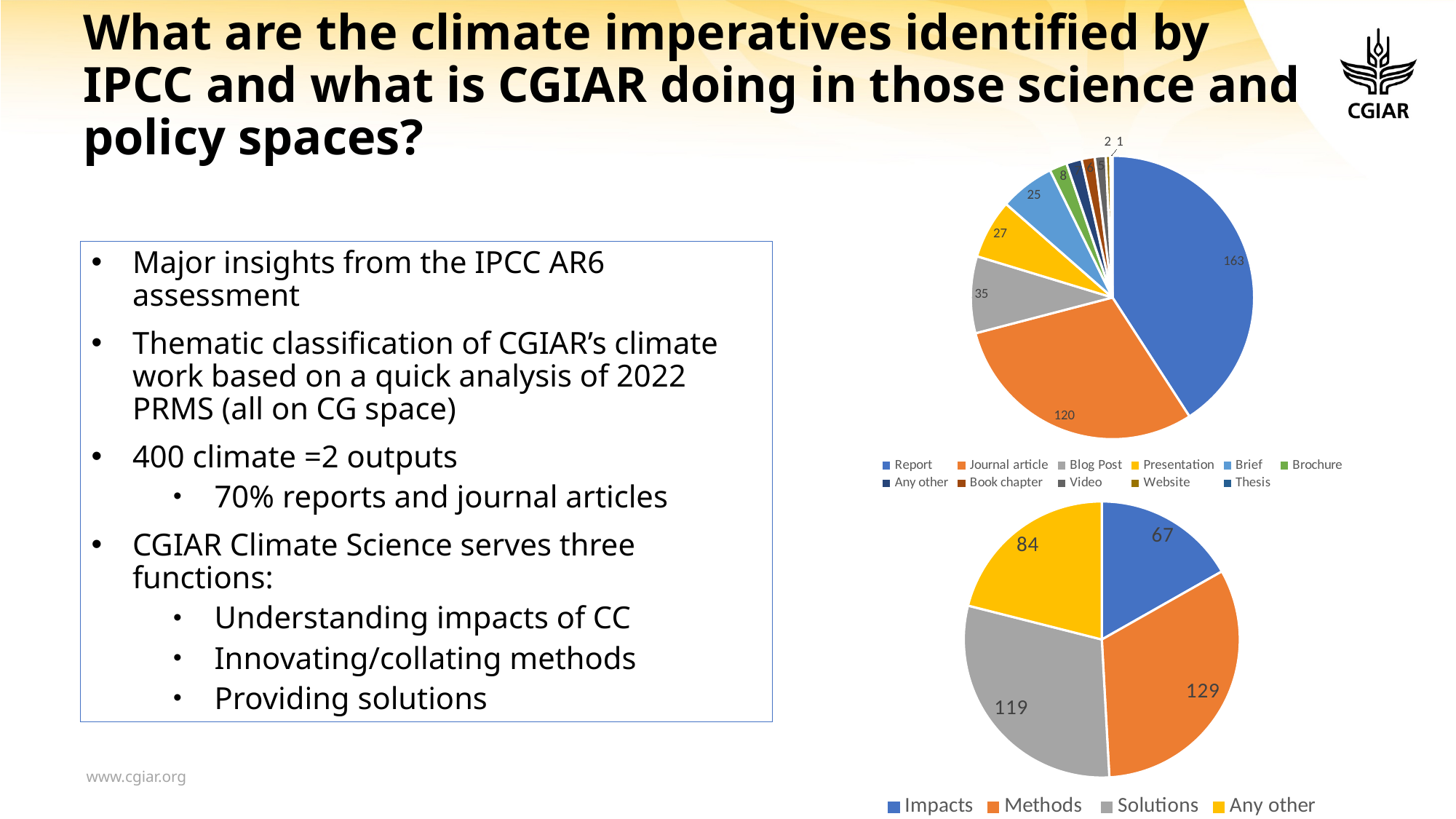
In the top pie chart, what is the value for Report? 163 In the bottom pie chart, what is the value for Methods? 129 What type of chart is the bottom chart on the slide? Pie chart In the bottom pie chart, which category has the smallest slice? Impacts In the top pie chart, what is the difference between the Report and Journal article values? 43 In the bottom pie chart, which is larger, Solutions or Any other? Solutions In the top pie chart, which category has the largest slice? Report In the top pie chart, how many entries does the legend list? 11 In the bottom pie chart, how many categories are shown? 4 In the bottom pie chart, what is the value for Impacts? 67 In the top pie chart, what is the value for Journal article? 120 In the top pie chart, what is the value for Blog Post? 35